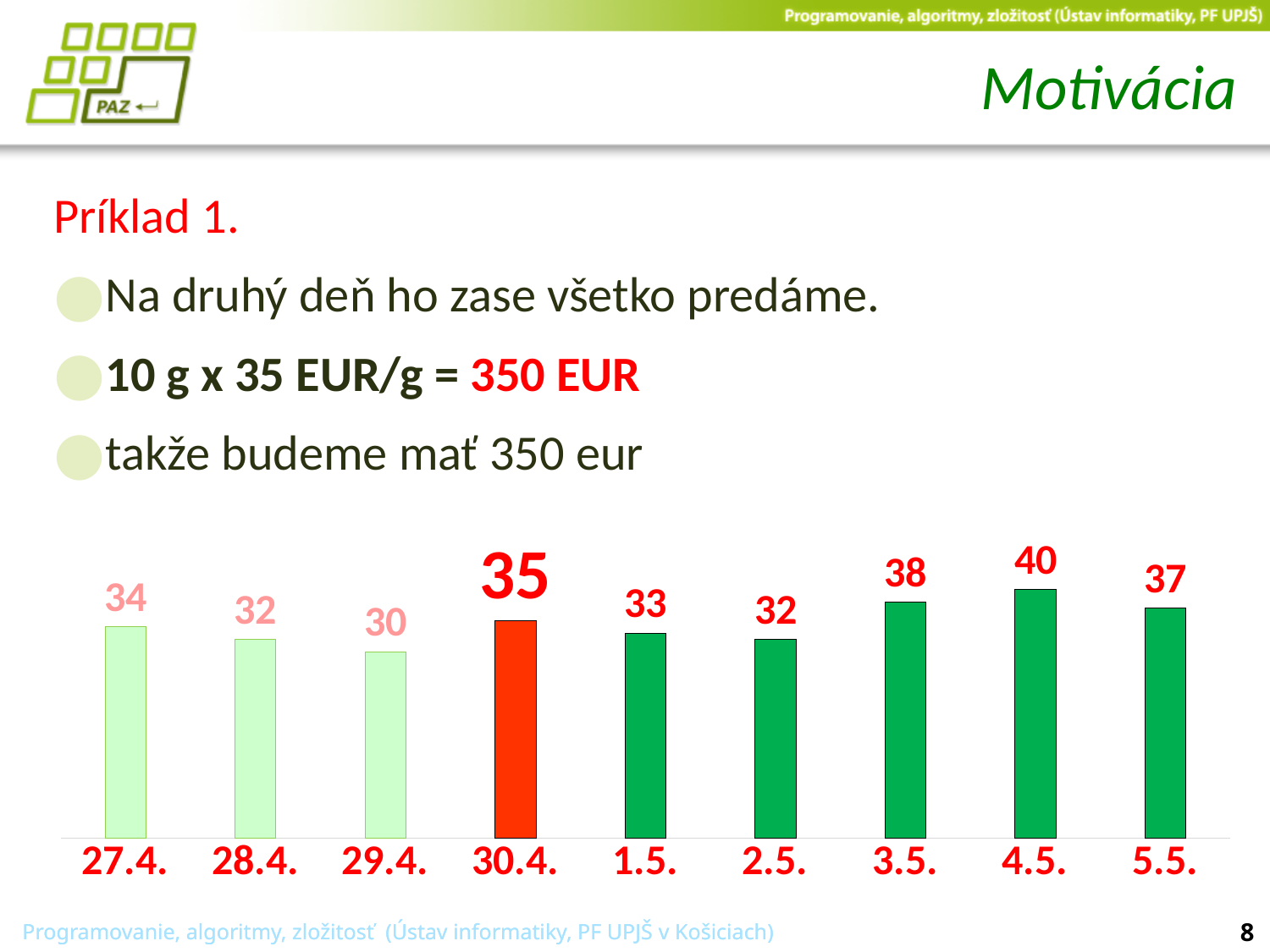
Which is larger, the value for 3.5. or the value for 5.5.? 3.5. Which date has the lowest value? 29.4. Which bar is coloured red? 30.4. What is the value for 4.5.? 40 What is the value for 30.4.? 35 Do the values rise or fall from 30.4. to 2.5.? fall What is the difference between the values for 4.5. and 30.4.? 5 What is the value for 29.4.? 30 What is the difference between the values for 27.4. and 29.4.? 4 Which date has the highest value? 4.5. What kind of chart is shown on the slide? bar chart How many dates are shown on the x axis? 9